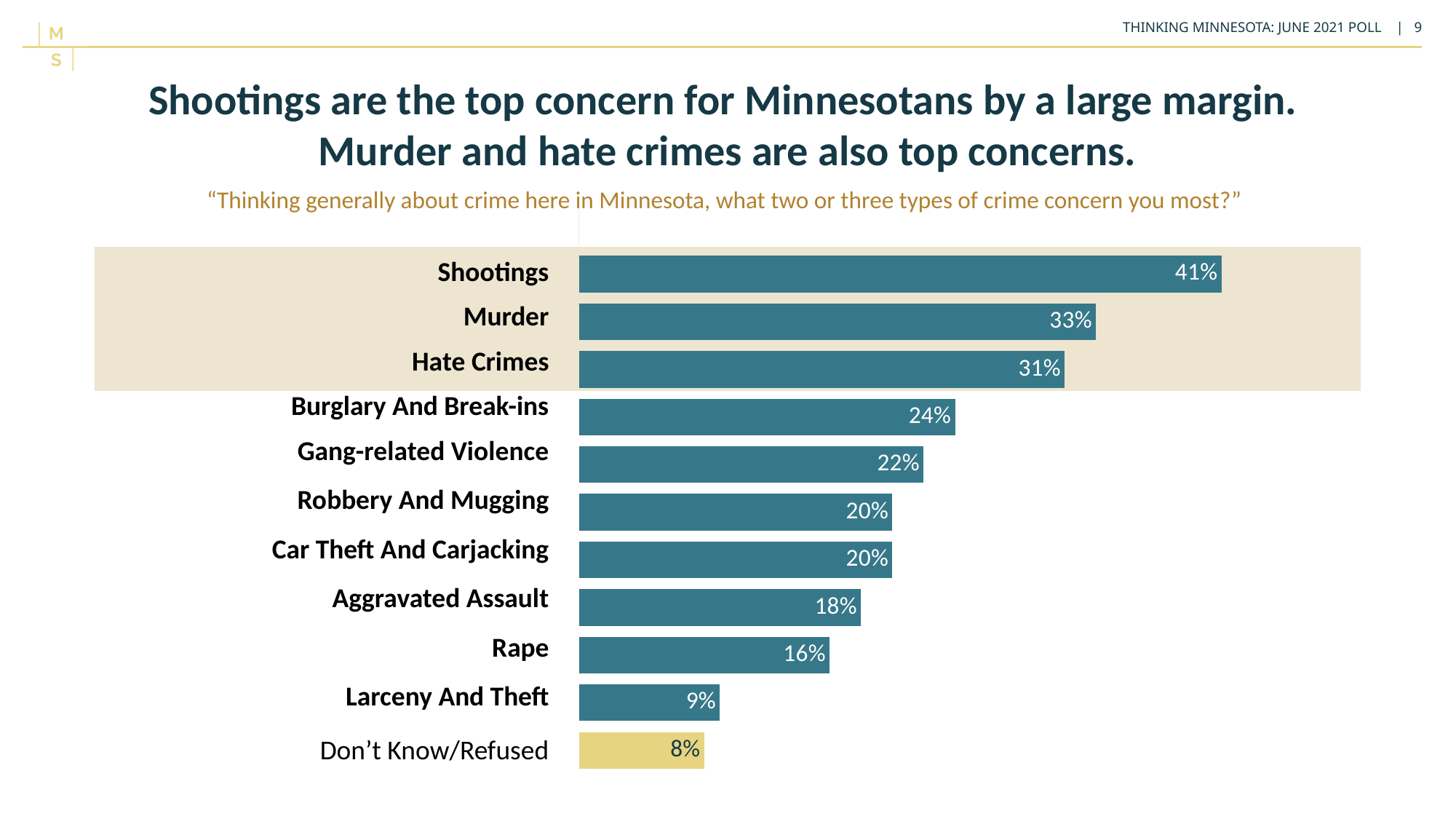
What is the difference between the values for Burglary And Break-ins and Rape? 8% What is the value shown for Hate Crimes? 31% What is the value shown for Aggravated Assault? 18% Which category's bar is shown in a different colour (yellow) from the others? Don't Know/Refused What is the difference between the values for Shootings and Murder? 8% Which three categories are highlighted with a shaded background? Shootings, Murder, Hate Crimes Which is larger, the value for Gang-related Violence or the value for Robbery And Mugging? Gang-related Violence Which category has the lowest value? Don't Know/Refused How many categories are shown in the chart? 11 What kind of chart is shown on the slide? Bar chart Which category has the highest value? Shootings What percentage of respondents named Shootings as a top concern? 41%